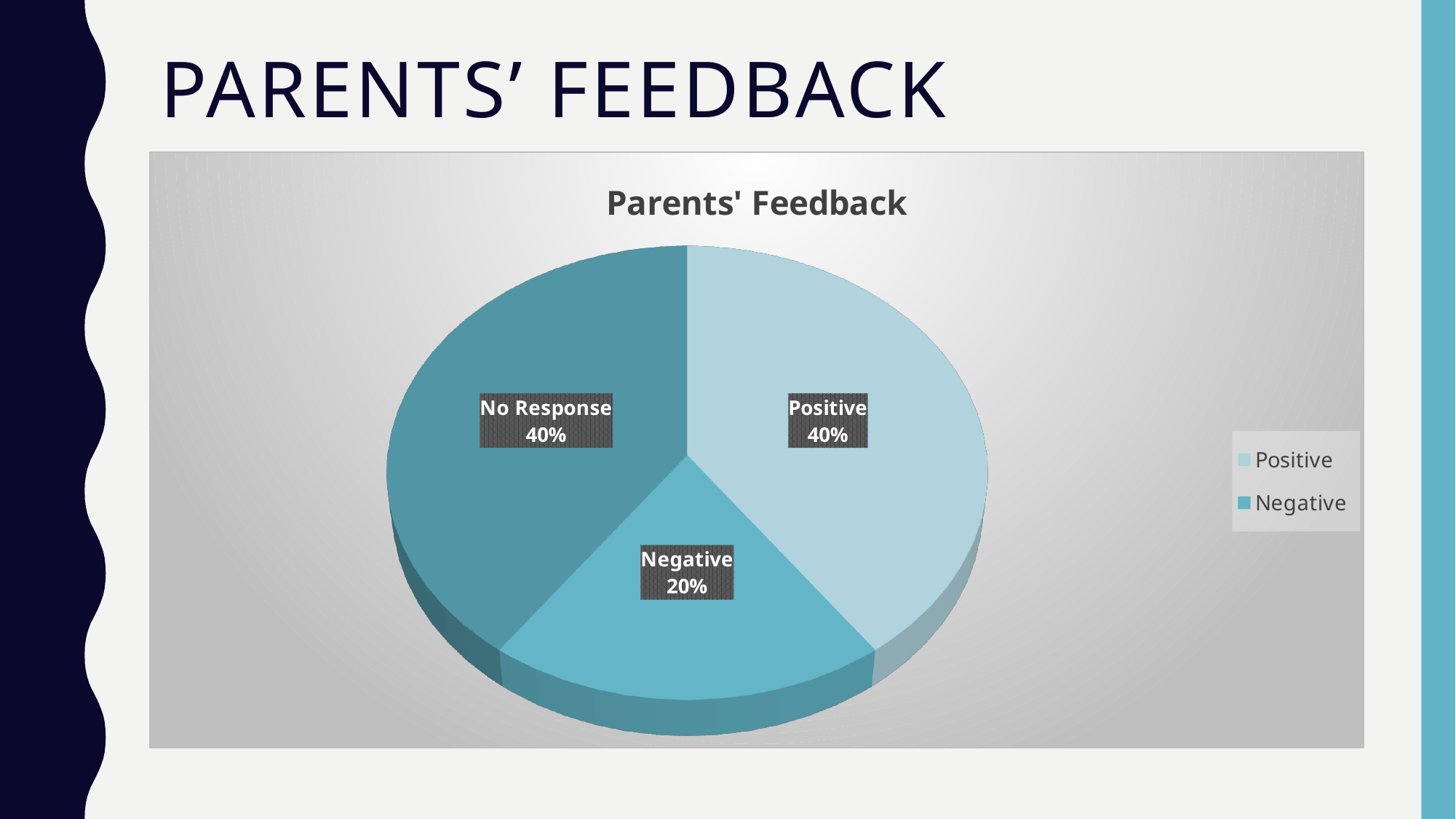
What is the difference between the Positive share and the Negative share? 20% Which slice is shown in the lightest blue colour? Positive How many entries does the legend list? 2 What is the combined share of the Positive and No Response slices? 80% What percentage of the pie is labelled No Response? 40% What is the title of the chart? Parents' Feedback What percentage of the pie is labelled Negative? 20% What percentage of the pie is labelled Positive? 40% Which is larger, the No Response slice or the Negative slice? No Response Which slice of the pie is the smallest? Negative How many slices does the pie chart have? 3 What type of chart is shown on the slide? Pie chart